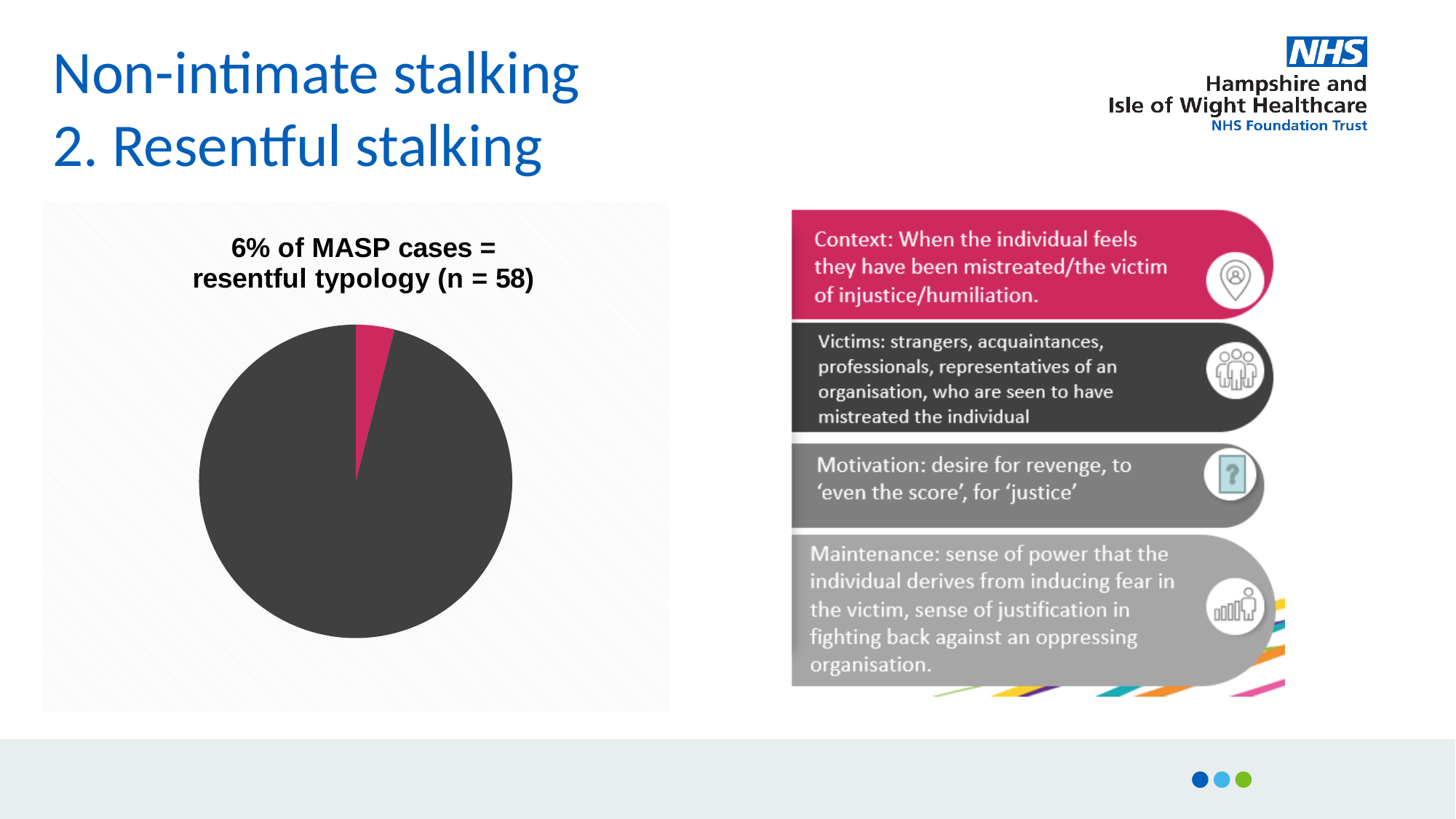
According to the pie chart title, what percentage of MASP cases are the resentful typology? 6% What kind of chart is shown on the slide? pie chart How many slices does the pie chart have? 2 What colour is the slice representing the resentful typology cases in the pie chart? pink What is the value of n given in the pie chart title? 58 Is the share of the pink slice in the pie chart greater or less than 50%? less What is the title of the pie chart? 6% of MASP cases = resentful typology (n = 58) Is the share of the dark grey slice in the pie chart greater or less than 50%? greater Which slice of the pie chart is larger, the pink slice or the dark grey slice? dark grey slice